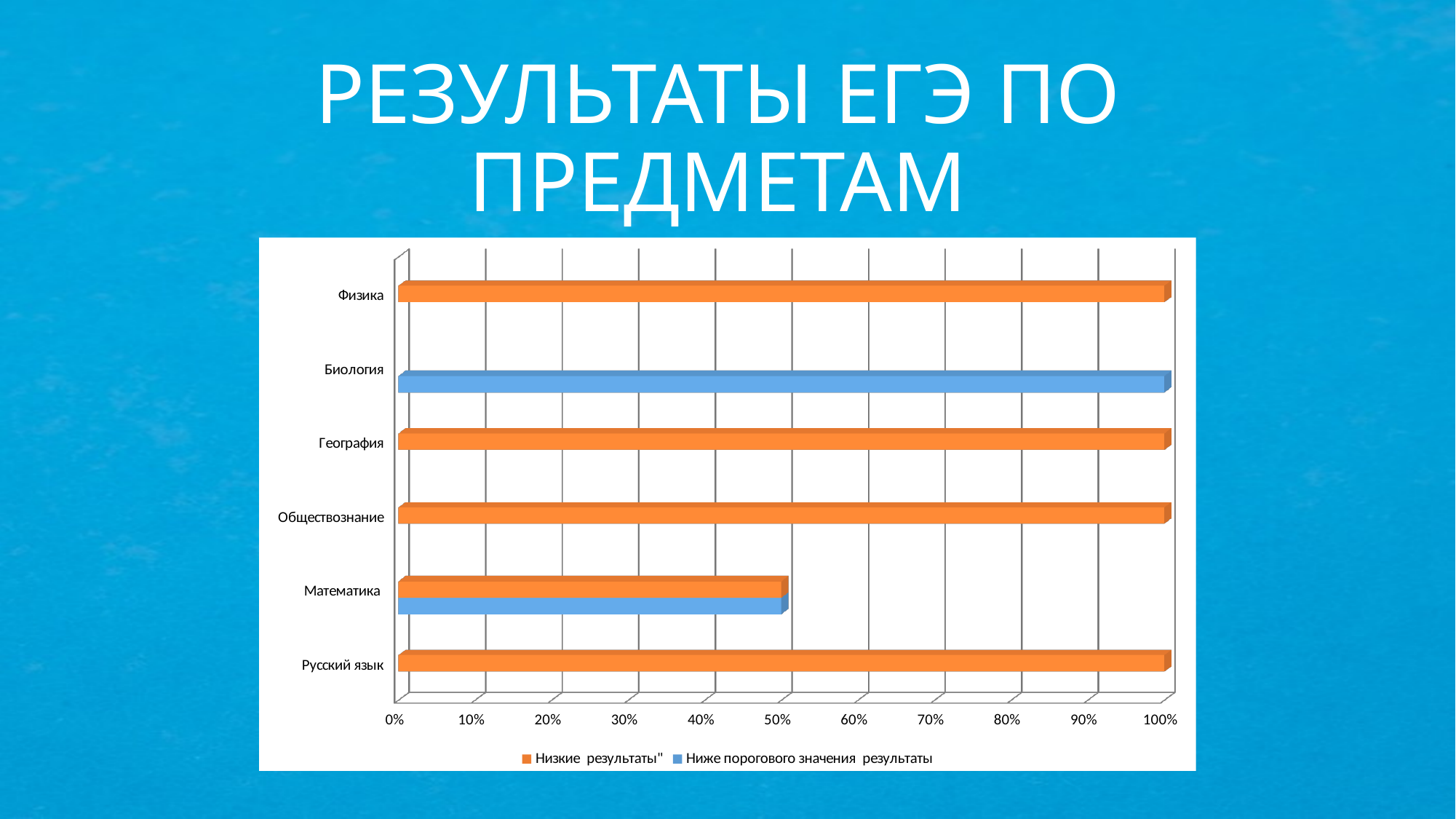
Which has the larger "Низкие результаты" value, Русский язык or Математика? Русский язык Which subject has the lowest value for "Низкие результаты"? Математика What colour represents the "Низкие результаты" series? orange What is the difference between the "Низкие результаты" values for Физика and Математика? 50% What is the value of "Низкие результаты" for Физика? 100% How many series does the chart legend list? 2 What kind of chart is shown on the slide? bar chart What is the value of "Низкие результаты" for Математика? 50% Is the value for Математика greater or less than 60%? less What is the value of "Ниже порогового значения результаты" for Биология? 100% How many subjects (categories) are listed on the chart? 6 What is the title of the slide? РЕЗУЛЬТАТЫ ЕГЭ ПО ПРЕДМЕТАМ